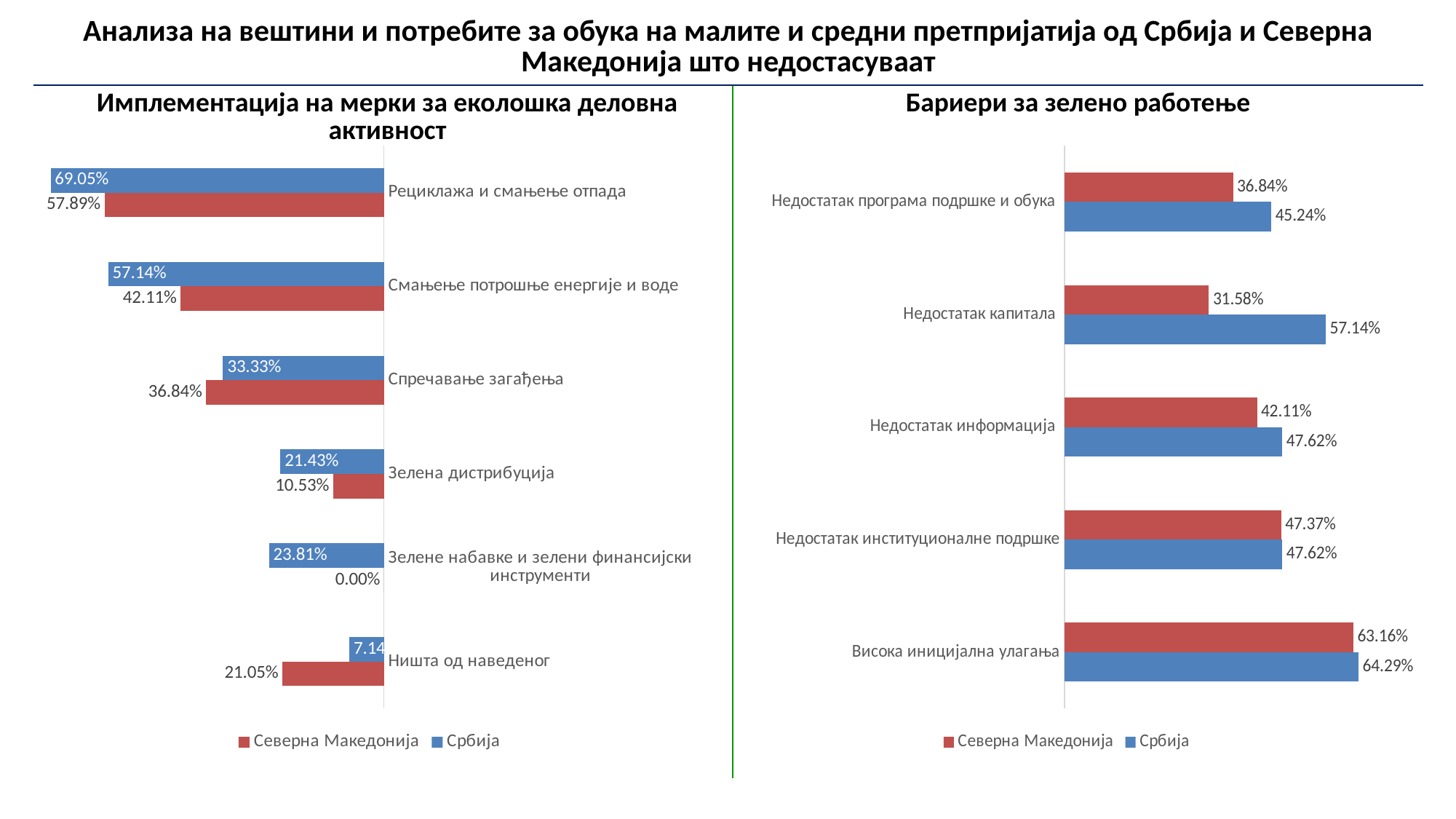
In the chart 'Имплементација на мерки за еколошка деловна активност', what is the value for Србија for 'Рециклажа и смањење отпада'? 69.05% In the chart 'Бариери за зелено работење', which is larger for 'Недостатак капитала': the value for Србија or for Северна Македонија? Србија In the chart 'Бариери за зелено работење', what is the value for Северна Македонија for 'Висока иницијална улагања'? 63.16% In the chart 'Имплементација на мерки за еколошка деловна активност', how many categories are shown? 6 In the chart 'Бариери за зелено работење', what is the value for Србија for 'Недостатак капитала'? 57.14% In the chart 'Бариери за зелено работење', what is the difference between the Србија and Северна Македонија values for 'Недостатак програма подршке и обука'? 8.40% In the chart 'Имплементација на мерки за еколошка деловна активност', what is the difference between the Србија and Северна Македонија values for 'Зелена дистрибуција'? 10.90% In the chart 'Имплементација на мерки за еколошка деловна активност', what is the value for Северна Македонија for 'Смањење потрошње енергије и воде'? 42.11% How many series does the legend of the chart 'Бариери за зелено работење' list? 2 In the chart 'Имплементација на мерки за еколошка деловна активност', which category has the highest value for Северна Македонија? Рециклажа и смањење отпада In the chart 'Бариери за зелено работење', which category has the highest value for Србија? Висока иницијална улагања In the chart 'Имплементација на мерки за еколошка деловна активност', which category has the lowest value for Северна Македонија? Зелене набавке и зелени финансијски инструменти